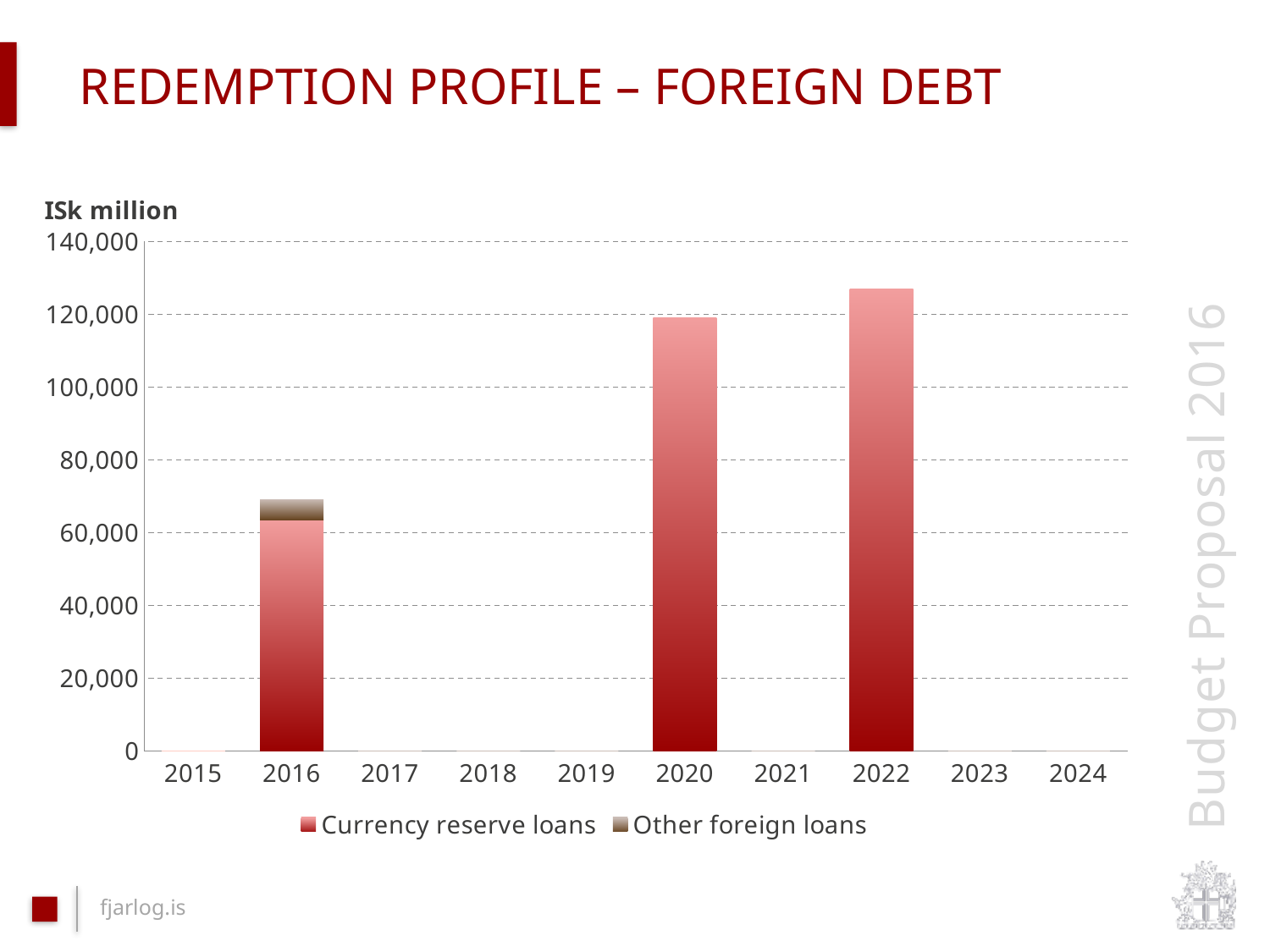
What is the title of the slide? REDEMPTION PROFILE – FOREIGN DEBT Is the Currency reserve loans value for 2016 greater or less than 60,000? greater What unit is shown above the y axis? ISk million Which year has the highest total foreign debt redemption? 2022 Is the total value for 2016 greater or less than 80,000? less How many series does the legend list? 2 Is the total value for 2022 greater or less than 120,000? greater What kind of chart is shown on the slide? Stacked bar chart How many years are shown on the x axis? 10 Which year has a larger total, 2016 or 2020? 2020 In which year does the Other foreign loans series appear? 2016